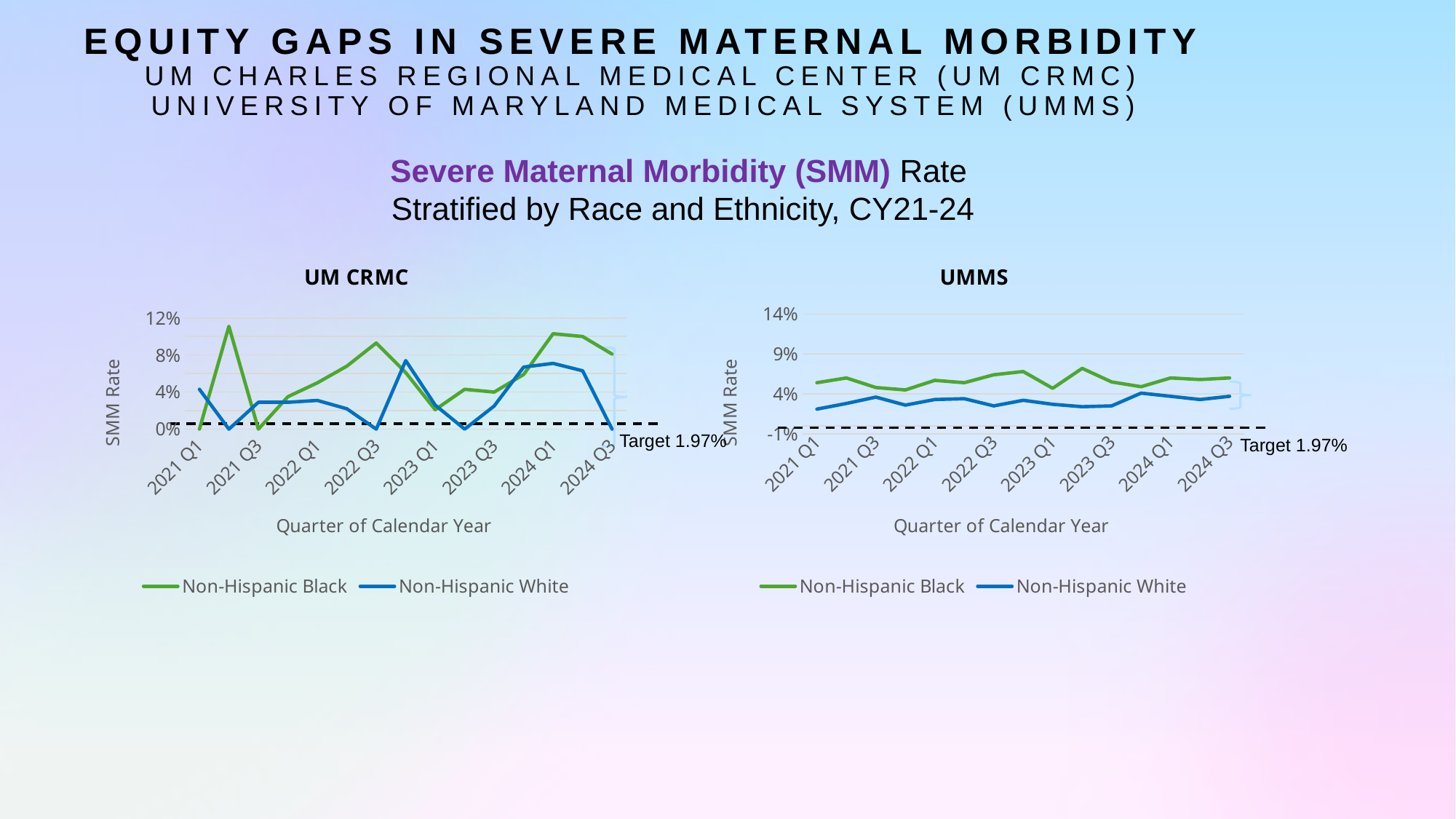
In the UM CRMC chart, which series has the higher value at 2024 Q1, Non-Hispanic Black or Non-Hispanic White? Non-Hispanic Black In the UMMS chart, which series has the higher value at 2021 Q1, Non-Hispanic Black or Non-Hispanic White? Non-Hispanic Black In the UM CRMC chart, is the value for Non-Hispanic White at 2024 Q3 greater or less than 4%? less In the UMMS chart, is the value for Non-Hispanic White at 2021 Q1 greater or less than 4%? less What are the two series named in the legend of the UM CRMC chart? Non-Hispanic Black and Non-Hispanic White What kind of chart is the UM CRMC chart? line chart What is the highest tick value shown on the y axis of the UMMS chart? 14% What target value is labelled on the dashed line in the UMMS chart? Target 1.97% In the UM CRMC chart, is the value for Non-Hispanic Black at 2024 Q1 greater or less than 8%? greater In the UM CRMC chart, which series reaches the highest value across the whole period? Non-Hispanic Black How many series does the legend of the UMMS chart list? 2